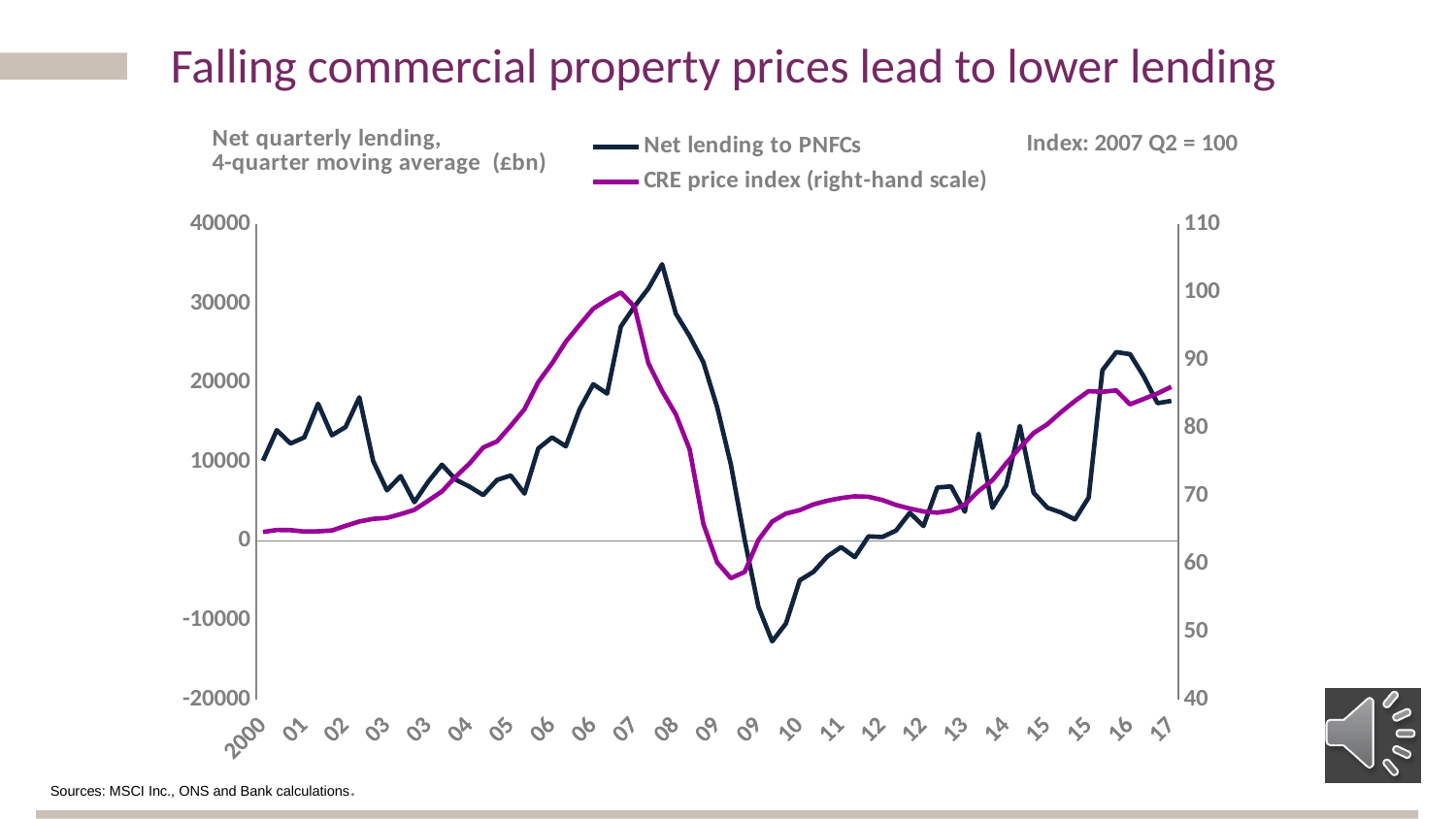
Is the peak value of the CRE price index around 2007 greater or less than 90? greater Is the lowest value of Net lending to PNFCs around 2010 greater or less than -10000? less Is the value of the CRE price index at the end of the series (2017) greater or less than 80? greater What kind of chart is shown on the slide? line chart Which series is plotted on the right-hand scale? CRE price index Does the CRE price index rise or fall between 2009 and 2017? rise What is the base period of the index shown on the right-hand scale? 2007 Q2 = 100 How many series does the legend list? 2 Is Net lending to PNFCs higher in 2008 or in 2010? 2008